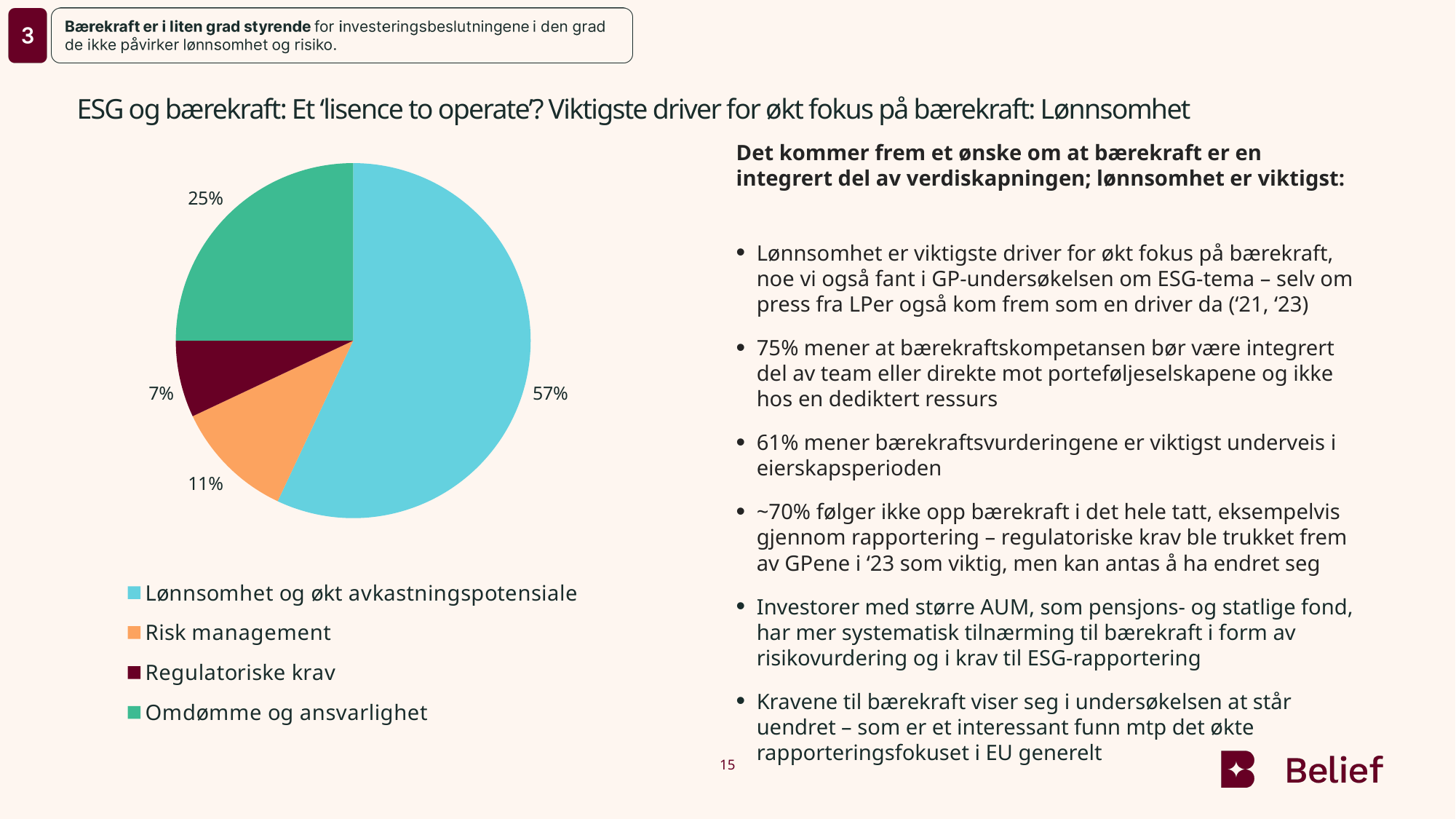
What is the difference between the shares for "Risk management" and "Regulatoriske krav"? 4 percentage points What colour is the slice for "Omdømme og ansvarlighet"? Green What is the value shown for "Regulatoriske krav"? 7% Which category has the largest slice of the pie? Lønnsomhet og økt avkastningspotensiale What kind of chart is shown on the slide? Pie chart What is the value shown for "Risk management"? 11% Which category has the smallest slice of the pie? Regulatoriske krav What share of the pie does "Lønnsomhet og økt avkastningspotensiale" represent? 57% Which is larger: the share for "Risk management" or for "Regulatoriske krav"? Risk management What is the difference between the shares for "Lønnsomhet og økt avkastningspotensiale" and "Omdømme og ansvarlighet"? 32 percentage points How many categories does the pie chart show? 4 What is the value shown for "Omdømme og ansvarlighet"? 25%